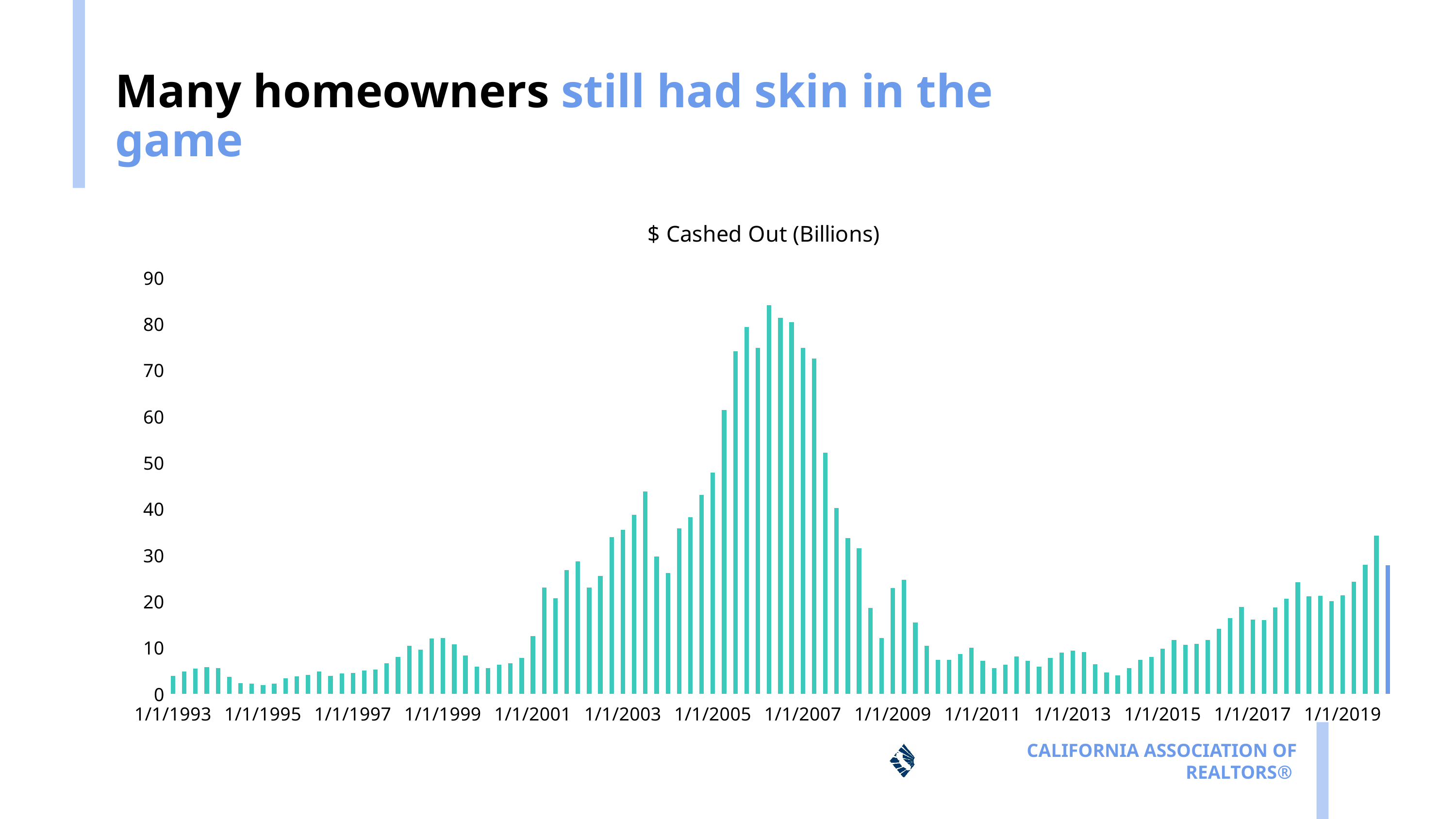
Among the dates labeled on the x axis, which has the highest bar? 1/1/2007 Which has the larger value, 1/1/2007 or 1/1/1993? 1/1/2007 Is the value for 1/1/2019 greater or less than 10? greater Is the value for 1/1/2005 greater or less than 40? greater Do the values generally rise or fall between 1/1/2007 and 1/1/2009? fall Is the value for 1/1/2013 greater or less than 20? less What is the title of the chart? $ Cashed Out (Billions) What is the highest value labeled on the vertical axis? 90 What kind of chart is shown on the slide? bar chart